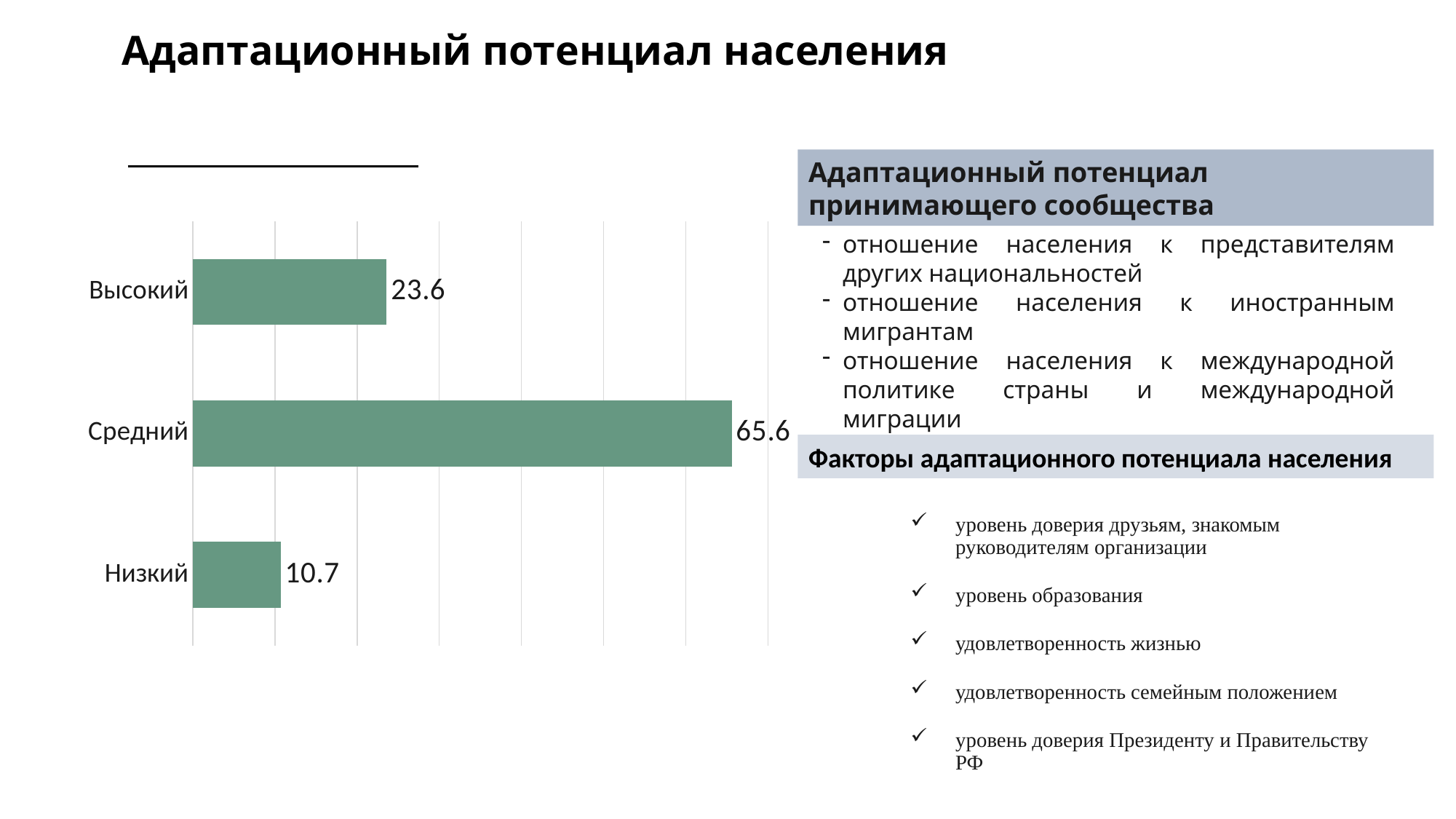
Which is larger, the value for Высокий or the value for Низкий? Высокий Which category has the highest value? Средний What is the difference between the values for Средний and Высокий? 42.0 How many categories are shown in the chart? 3 What is the value for Средний? 65.6 Which is larger, the value for Средний or the value for Высокий? Средний What is the value for Низкий? 10.7 What is the value for Высокий? 23.6 Which category has the lowest value? Низкий What is the total of the three values shown in the chart? 99.9 What is the difference between the values for Высокий and Низкий? 12.9 What kind of chart is shown on the slide? bar chart